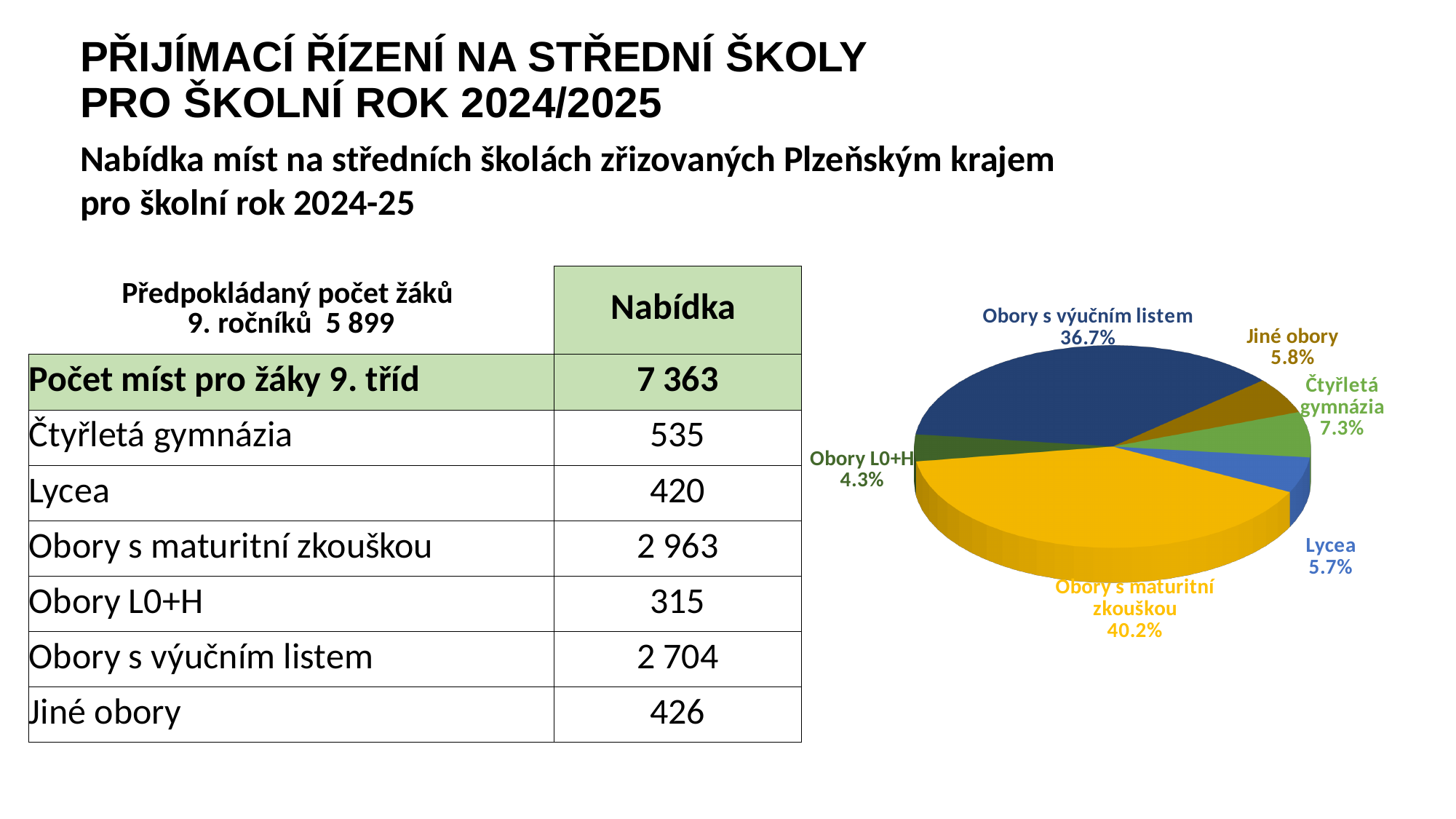
What type of chart is shown on the right of the slide? Pie chart In the pie chart, what share is shown for Obory L0+H? 4.3% In the pie chart, what is the difference in percentage points between Čtyřletá gymnázia and Obory L0+H? 3.0 percentage points Which slice of the pie chart is the largest? Obory s maturitní zkouškou Which slice of the pie chart is the smallest? Obory L0+H In the pie chart, what is the difference in percentage points between Obory s maturitní zkouškou and Obory s výučním listem? 3.5 percentage points In the pie chart, what share is shown for Čtyřletá gymnázia? 7.3% In the pie chart, what share is shown for Obory s výučním listem? 36.7% In the pie chart, which has a larger share: Čtyřletá gymnázia or Lycea? Čtyřletá gymnázia How many slices does the pie chart have? 6 What colour is the largest slice of the pie chart? Yellow